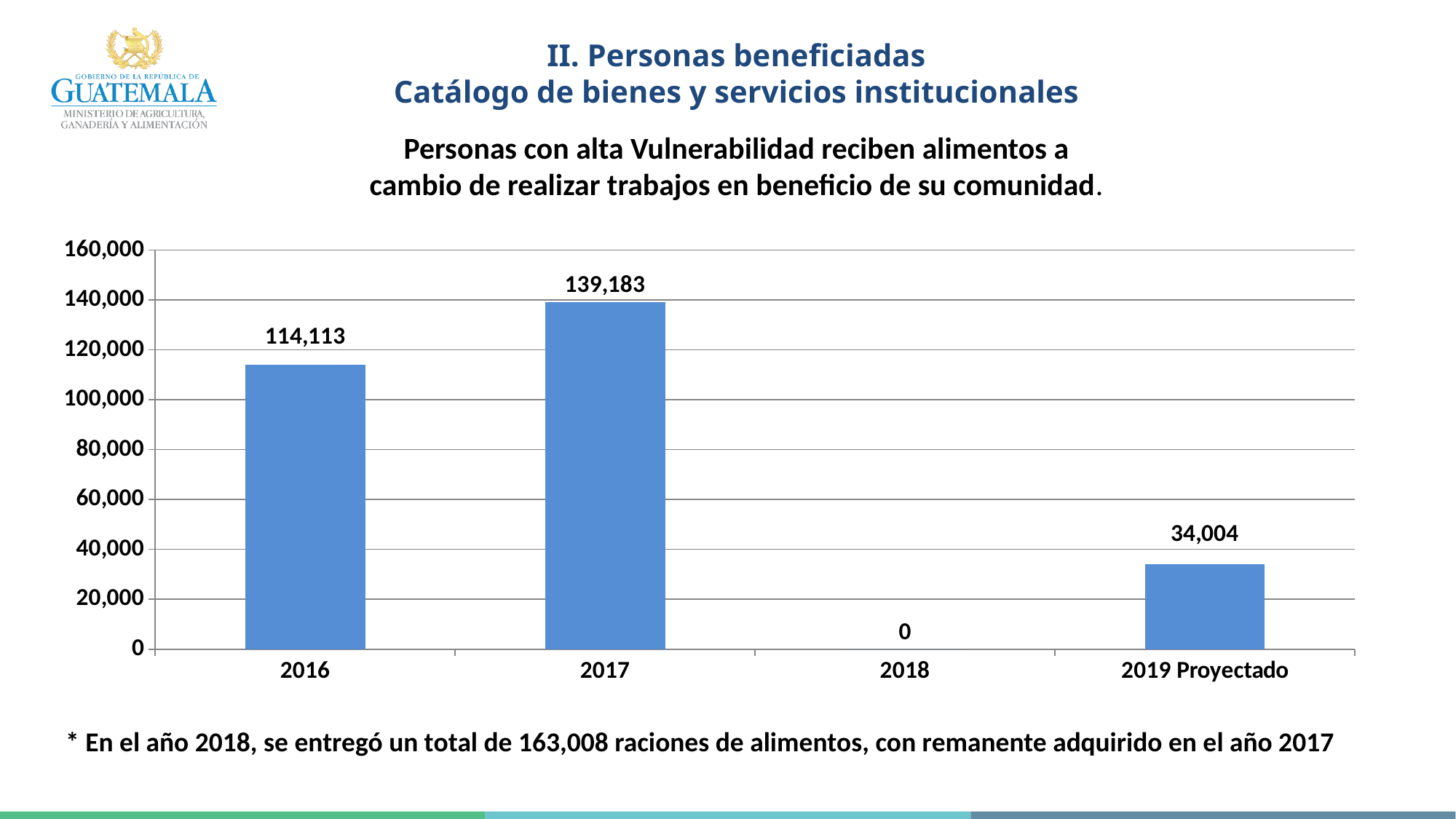
What is the value for 2017? 139,183 Is the value for 2019 Proyectado greater or less than 40,000? less Does the value rise or fall from 2016 to 2017? rise Which year has the highest value? 2017 What is the value for 2018? 0 What is the difference between the values for 2017 and 2016? 25,070 What is the value for 2016? 114,113 How many categories are shown on the x axis? 4 Which year has the lowest value? 2018 What kind of chart is shown on the slide? bar chart What is the value for 2019 Proyectado? 34,004 Which is larger, the value for 2016 or the value for 2019 Proyectado? 2016